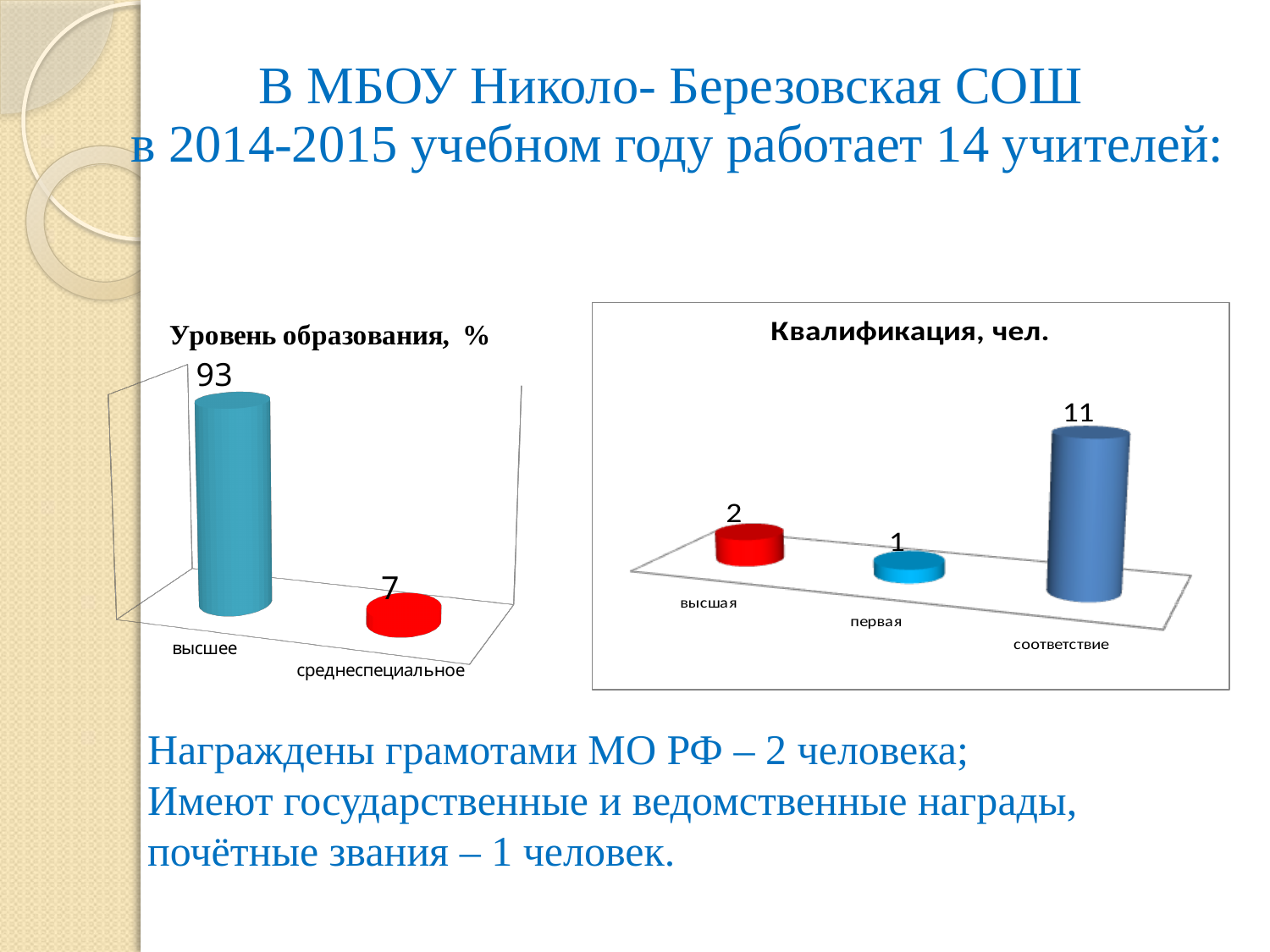
What kind of chart is the chart titled "Квалификация, чел."? bar chart In the chart titled "Уровень образования, %", what is the value for "среднеспециальное"? 7 In the chart titled "Квалификация, чел.", what is the difference between the values for "соответствие" and "высшая"? 9 In the chart titled "Уровень образования, %", what is the difference between the values for "высшее" and "среднеспециальное"? 86 In the chart titled "Уровень образования, %", how many categories are shown? 2 In the chart titled "Квалификация, чел.", which is larger, the value for "высшая" or the value for "первая"? высшая In the chart titled "Квалификация, чел.", what is the value for "высшая"? 2 In the chart titled "Квалификация, чел.", which category has the lowest value? первая In the chart titled "Уровень образования, %", which category has the highest value? высшее In the chart titled "Уровень образования, %", what is the value for "высшее"? 93 In the chart titled "Квалификация, чел.", what is the value for "соответствие"? 11 In the chart titled "Квалификация, чел.", what is the value for "первая"? 1